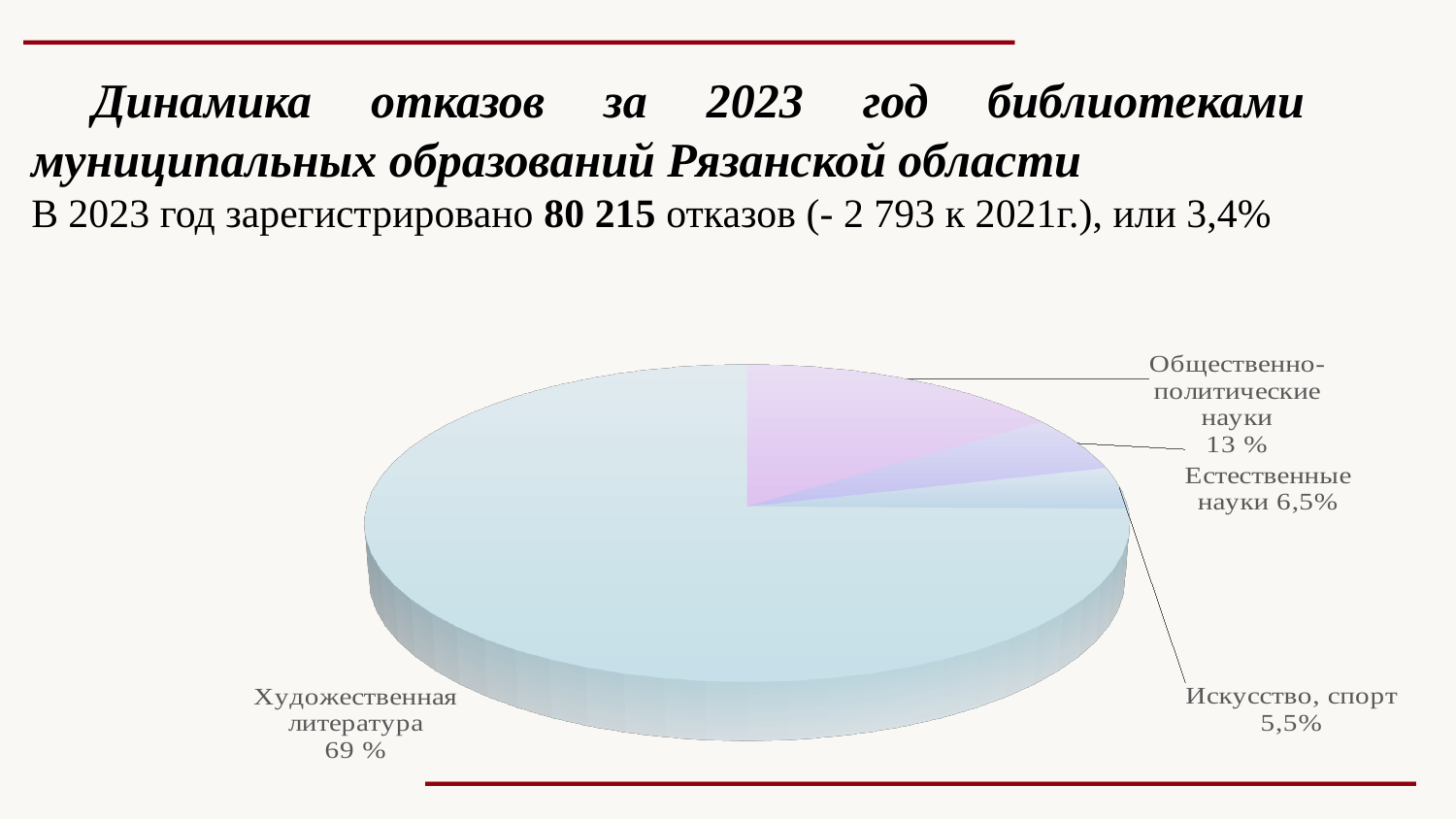
What is the difference in percentage points between the Общественно-политические науки slice and the Естественные науки slice? 6,5 What share of the pie is labelled for Общественно-политические науки? 13 % What total number of refusals (отказов) for 2023 is stated in the text above the chart? 80 215 What share of the pie is labelled for Художественная литература? 69 % What share of the pie is labelled for Искусство, спорт? 5,5% What share of the pie is labelled for Естественные науки? 6,5% Which category has the smallest slice of the pie? Искусство, спорт What is the difference in percentage points between the Художественная литература slice and the Общественно-политические науки slice? 56 Which category has the largest slice of the pie? Художественная литература Which slice is larger: Естественные науки or Искусство, спорт? Естественные науки How many slices does the pie chart have? 4 What kind of chart is shown on the slide? pie chart